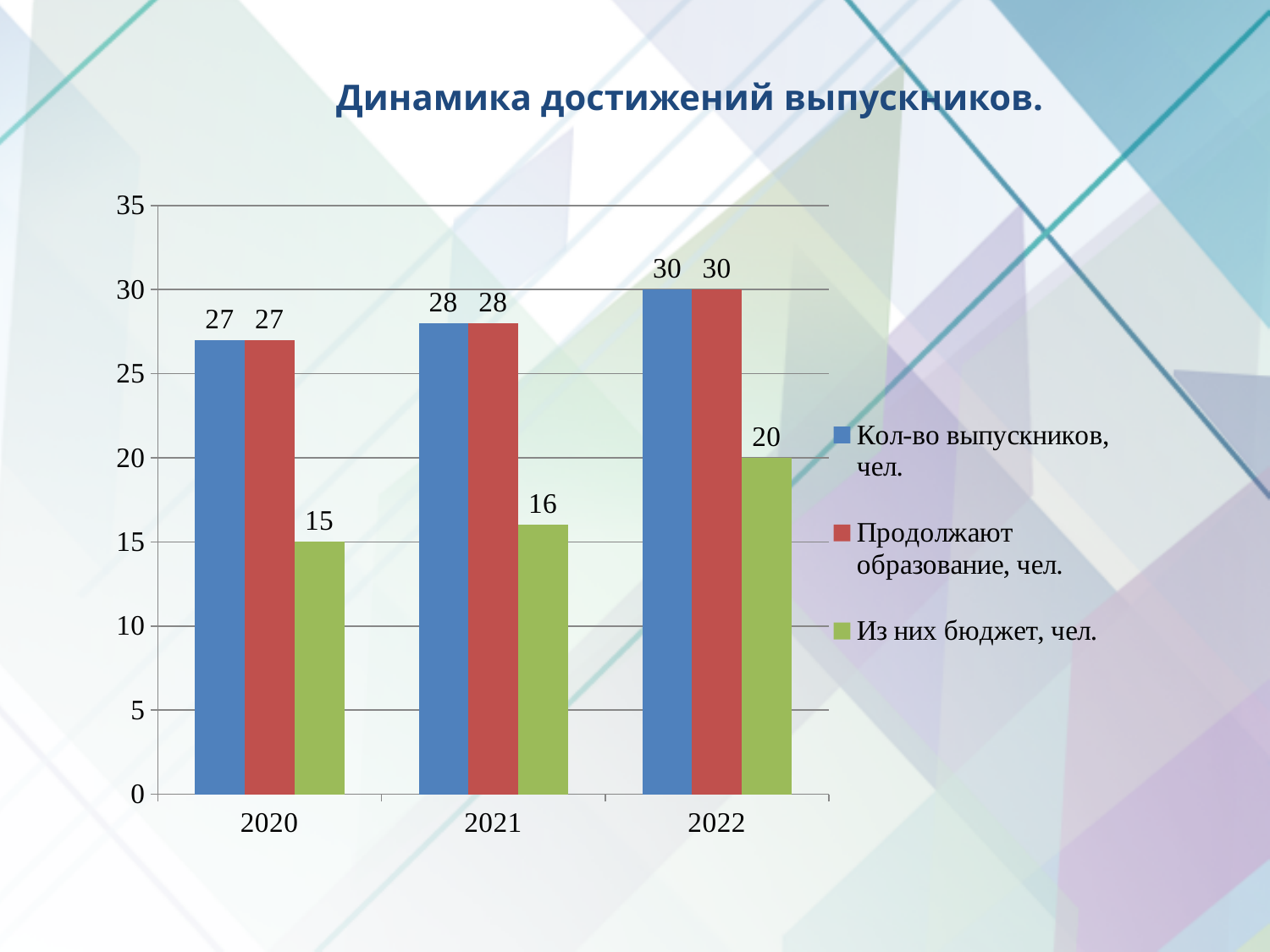
What is the title of the chart? Динамика достижений выпускников. What is the value for "Из них бюджет, чел." in 2020? 15 How many years are shown on the x axis? 3 How many series does the legend list? 3 In which year is the value for "Из них бюджет, чел." highest? 2022 Which is larger: "Из них бюджет, чел." in 2021 or in 2020? 2021 What is the value for "Продолжают образование, чел." in 2021? 28 Does the value for "Из них бюджет, чел." rise or fall from 2020 to 2022? rise In which year is the value for "Кол-во выпускников, чел." lowest? 2020 What is the value for "Кол-во выпускников, чел." in 2022? 30 What kind of chart is shown on the slide? bar chart What is the difference between "Продолжают образование, чел." and "Из них бюджет, чел." in 2022? 10